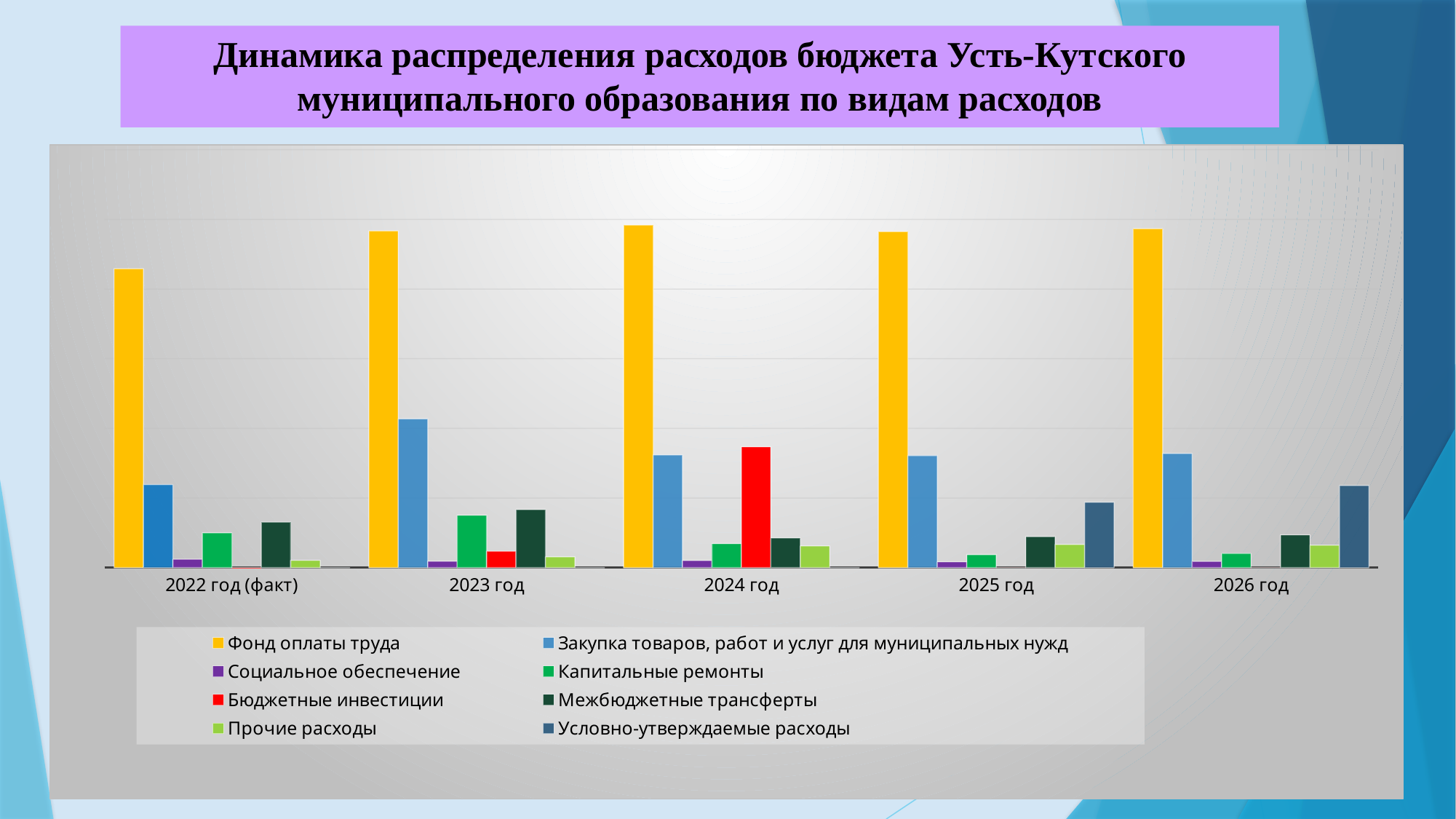
In which year is the bar for Фонд оплаты труда the lowest? 2022 год (факт) Which series has the tallest bar in every year? Фонд оплаты труда How many series does the legend list? 8 What kind of chart is shown on the slide? Bar chart What colour represents Фонд оплаты труда in the legend? Yellow Which year has the higher bar for Условно-утверждаемые расходы, 2025 год or 2026 год? 2026 год In 2023 год, which is larger: Закупка товаров, работ и услуг для муниципальных нужд or Капитальные ремонты? Закупка товаров, работ и услуг для муниципальных нужд Does the bar for Фонд оплаты труда rise or fall from 2022 год (факт) to 2023 год? Rise In which year is the bar for Закупка товаров, работ и услуг для муниципальных нужд the highest? 2023 год In which year is the bar for Бюджетные инвестиции the highest? 2024 год In 2026 год, which is larger: Закупка товаров, работ и услуг для муниципальных нужд or Условно-утверждаемые расходы? Закупка товаров, работ и услуг для муниципальных нужд How many year categories are shown on the x axis? 5